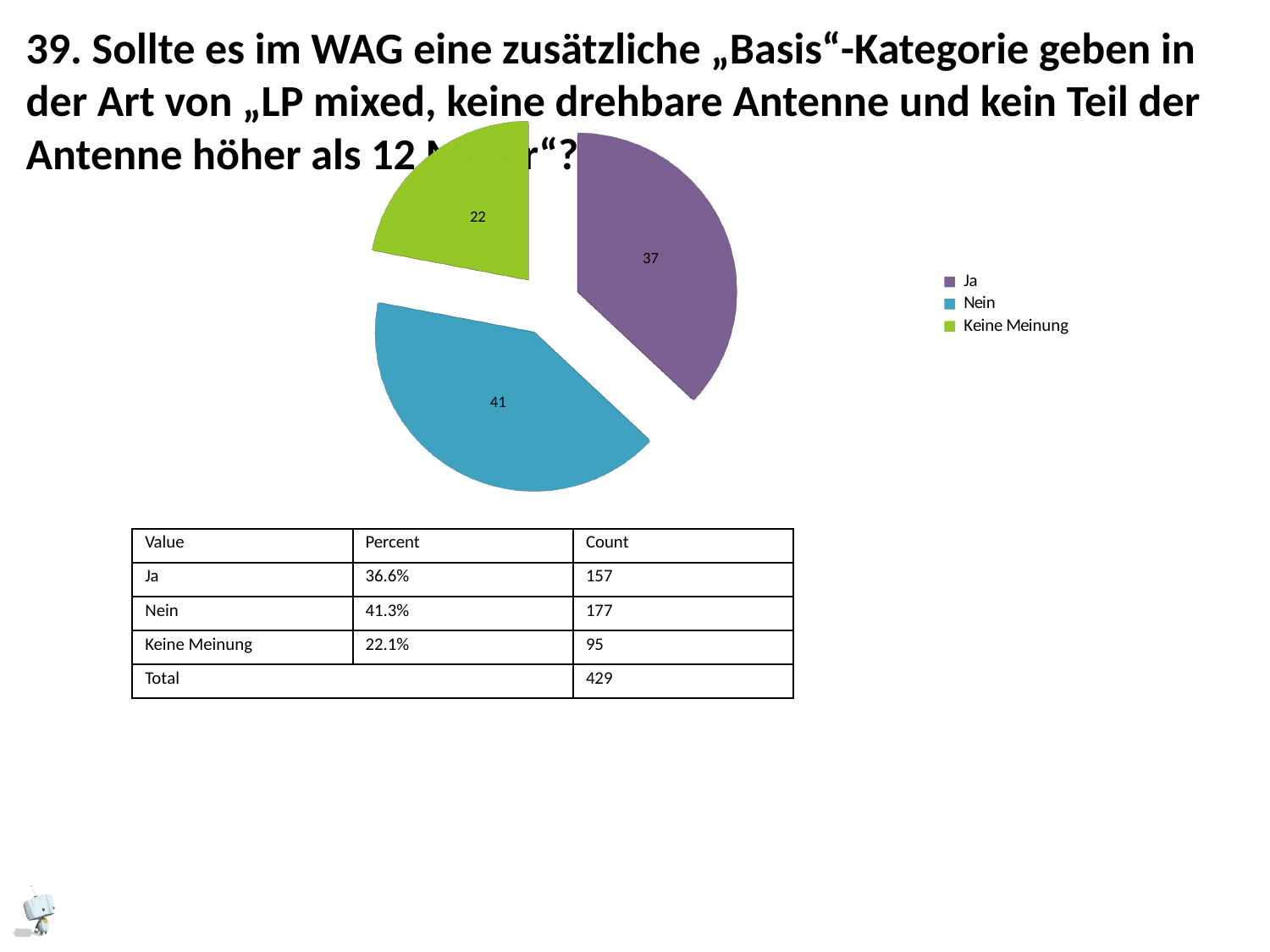
What is the difference between the values for Ja and Keine Meinung in the pie chart? 15 How many entries does the legend of the pie chart list? 3 What kind of chart is shown on the slide? pie chart What is the value shown for the Keine Meinung slice of the pie chart? 22 Which is larger in the pie chart, Ja or Keine Meinung? Ja What is the value shown for the Nein slice of the pie chart? 41 What is the difference between the values for Nein and Ja in the pie chart? 4 How many slices does the pie chart have? 3 What colour is the Keine Meinung slice in the pie chart? green What is the value shown for the Ja slice of the pie chart? 37 Which slice of the pie chart is the smallest? Keine Meinung Which slice of the pie chart is the largest? Nein